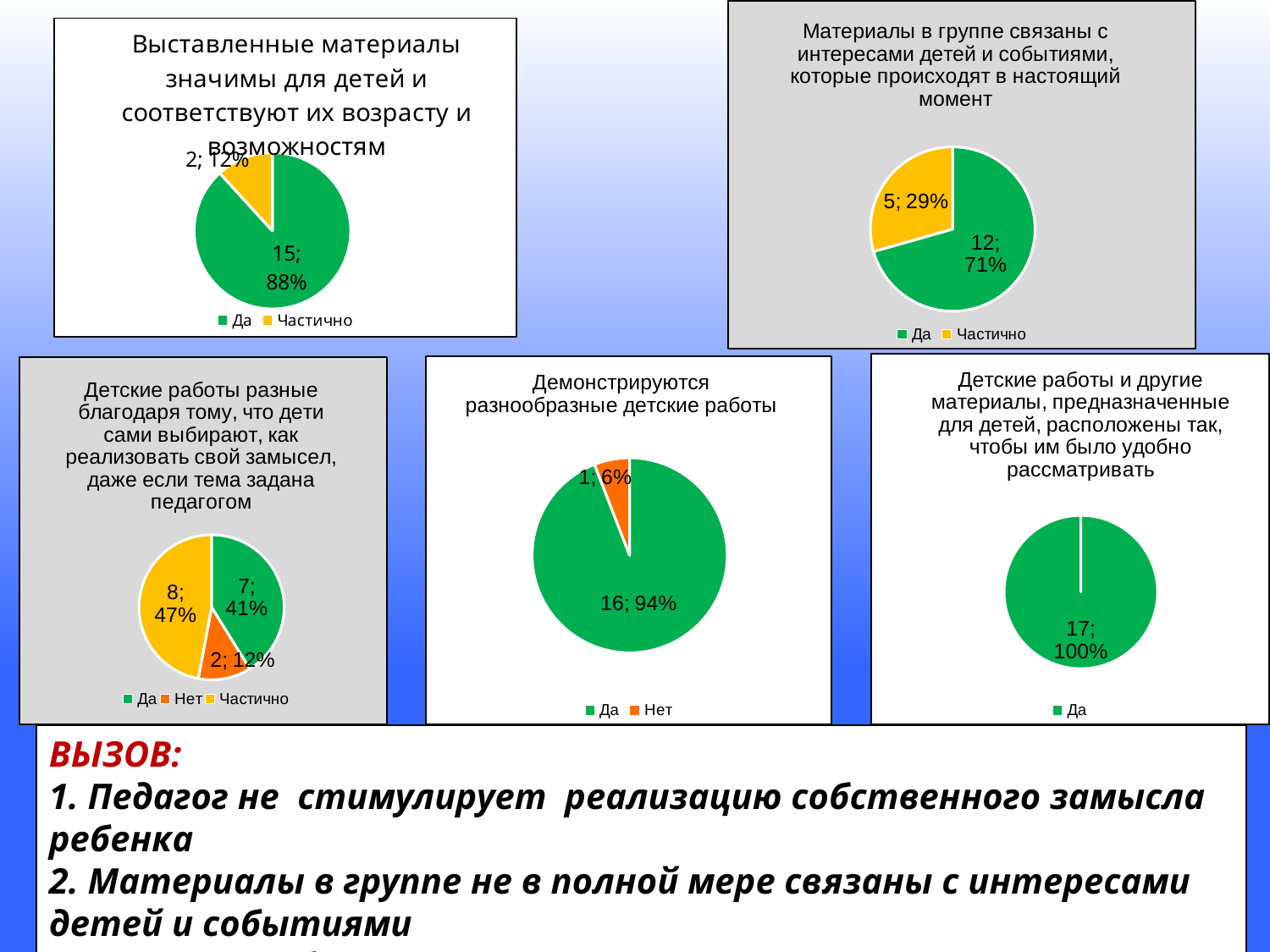
In the top-left pie chart ("Выставленные материалы значимы для детей..."), what percentage share does the "Да" slice have? 88% In the bottom-left pie chart ("Детские работы разные благодаря тому..."), which category has the smallest slice? Нет In the bottom-middle pie chart ("Демонстрируются разнообразные детские работы"), what is the count value for "Да"? 16 In the bottom-middle pie chart ("Демонстрируются разнообразные детские работы"), what percentage share does "Нет" have? 6% In the top-right pie chart ("Материалы в группе связаны с интересами детей..."), what is the count value for "Да"? 12 What type of chart is used for the bottom-right chart ("Детские работы и другие материалы... удобно рассматривать")? Pie chart In the top-left pie chart ("Выставленные материалы значимы для детей..."), what is the count value for "Частично"? 2 In the bottom-left pie chart ("Детские работы разные благодаря тому..."), what is the difference in count between "Частично" and "Да"? 1 In the bottom-left pie chart ("Детские работы разные благодаря тому..."), which category has the largest slice? Частично In the top-right pie chart ("Материалы в группе связаны с интересами детей..."), what percentage share does "Частично" have? 29% How many categories does the legend of the bottom-left pie chart ("Детские работы разные благодаря тому...") list? 3 In the bottom-right pie chart ("Детские работы и другие материалы... удобно рассматривать"), what is the count value for "Да"? 17